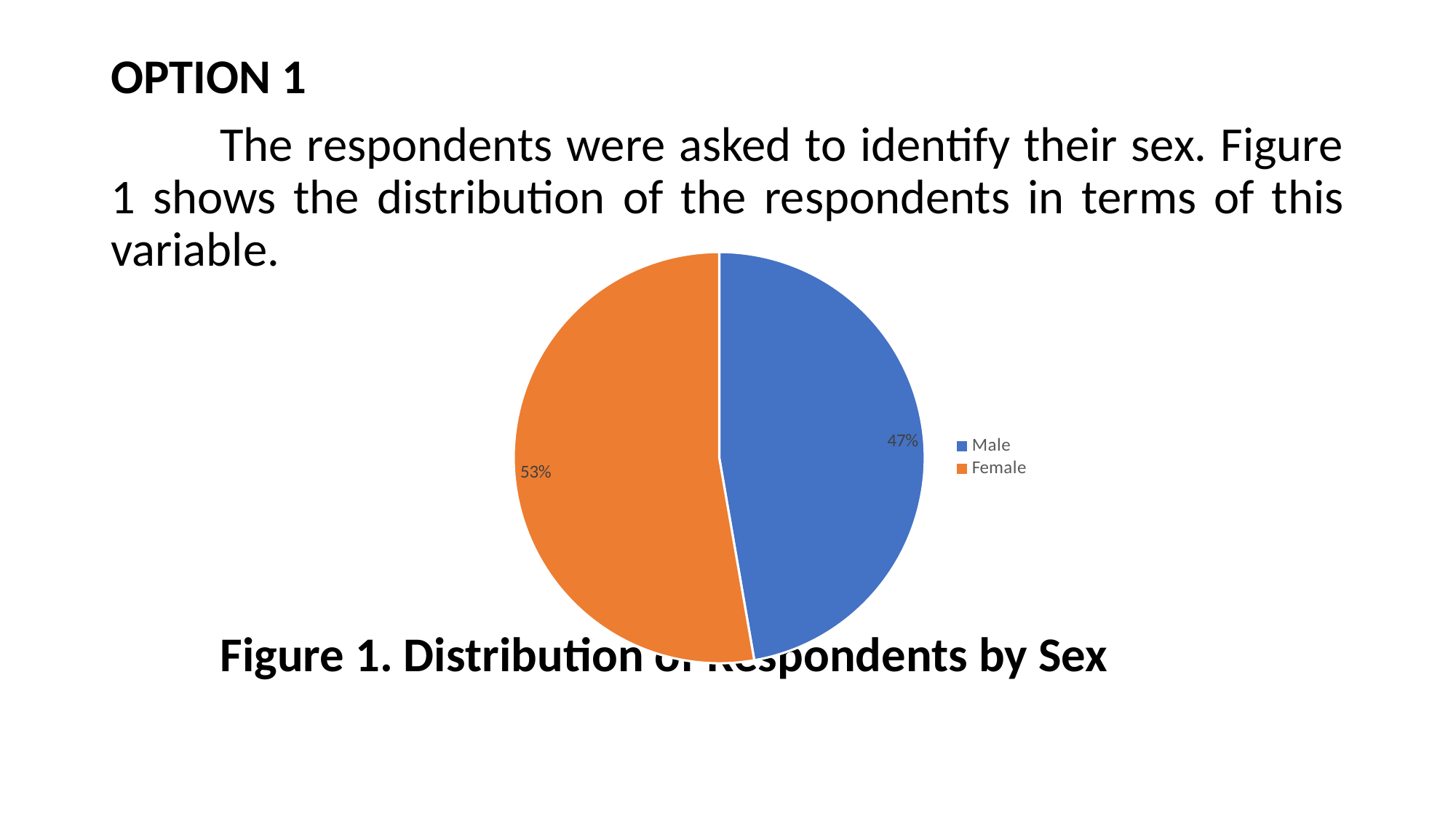
How many categories does the pie chart show? 2 How many entries does the legend list? 2 Which category has the largest share of the pie? Female Which is larger, the Male share or the Female share? Female What percentage of respondents are Female? 53% What colour is the Female slice? orange What kind of chart is shown on the slide? pie chart What percentage of respondents are Male? 47% What colour is the Male slice? blue Which category has the smallest share of the pie? Male What is the difference in percentage points between the Female and Male shares? 6